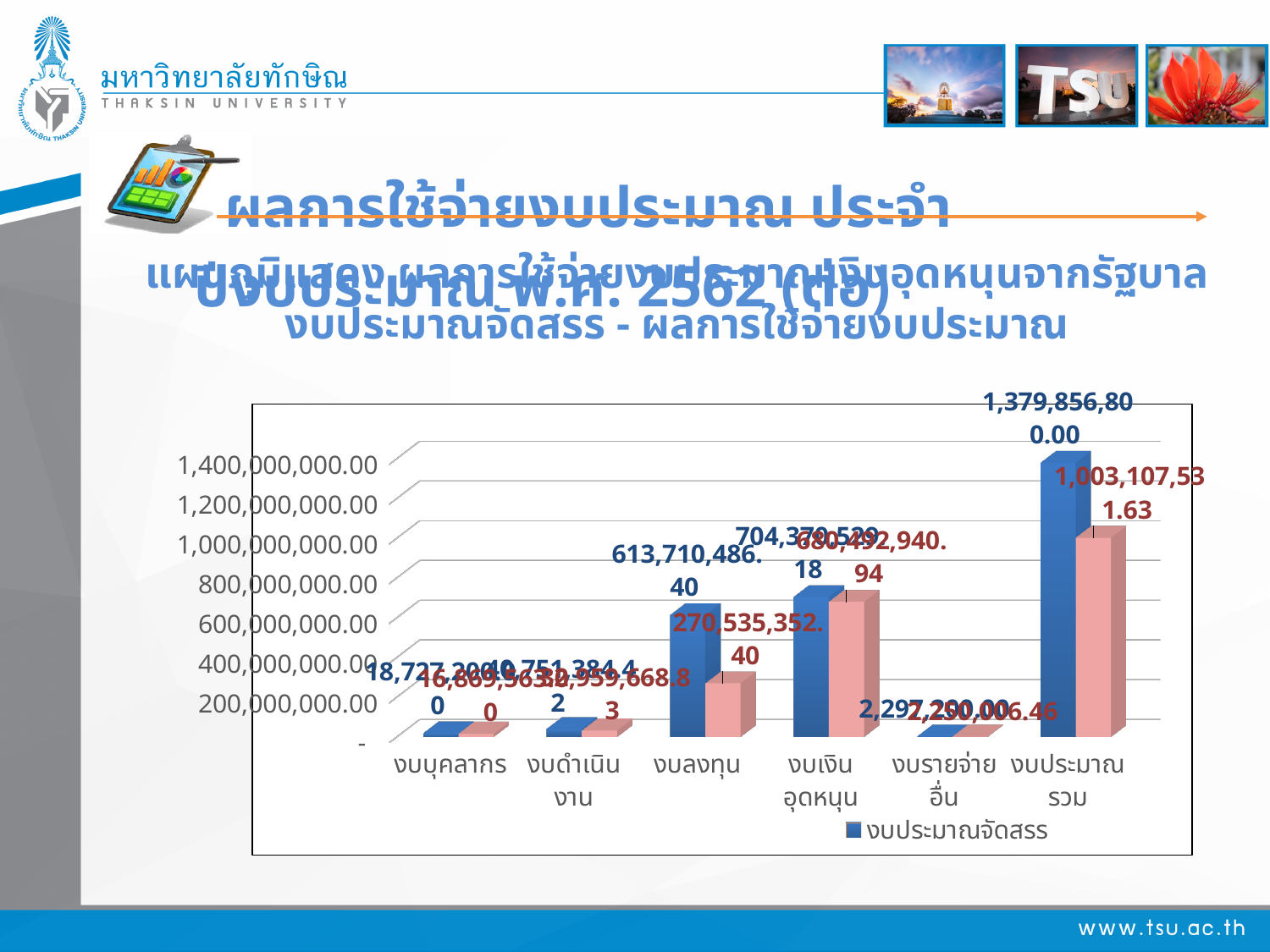
Which is larger for the blue bars: งบลงทุน or งบเงินอุดหนุน? งบเงินอุดหนุน How many categories are shown along the x axis of the chart? 6 Is the pink bar value for งบลงทุน greater or less than 400,000,000.00? less Which category has the highest งบประมาณจัดสรร (blue bar) value? งบประมาณรวม What kind of chart is shown on the slide? Bar chart Which category has the lowest งบประมาณจัดสรร (blue bar) value? งบรายจ่ายอื่น What is the difference between the blue bar and the pink bar for งบประมาณรวม? 376,749,268.37 What is the งบประมาณจัดสรร (blue bar) value for งบประมาณรวม? 1,379,856,800.00 What is the value of the pink bar for งบประมาณรวม? 1,003,107,531.63 Is the blue bar value for งบลงทุน greater or less than 600,000,000.00? greater What is the series name shown in the chart's legend? งบประมาณจัดสรร